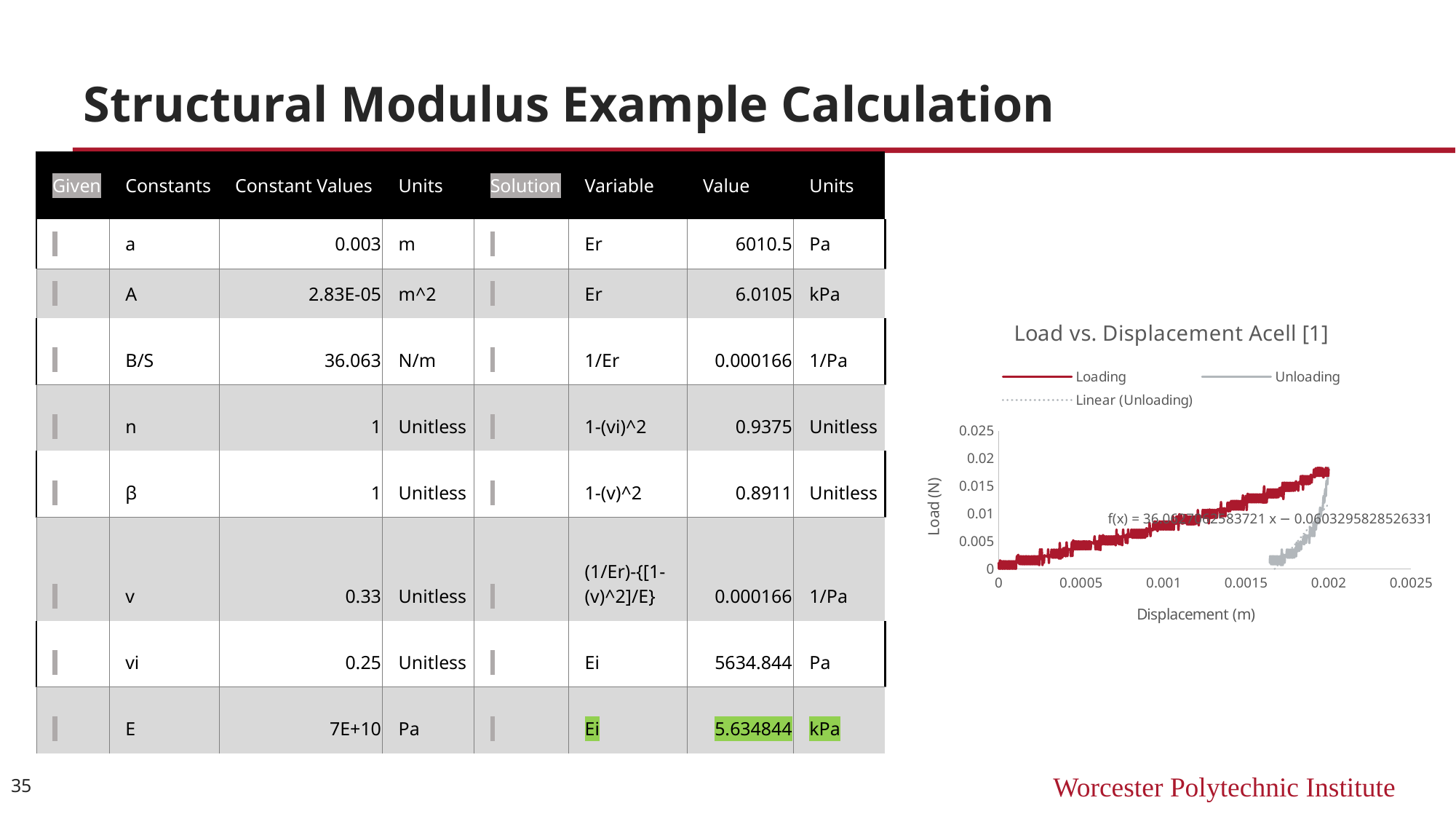
In the Load vs. Displacement chart, is the displacement at which the Unloading series starts (its lowest load point) greater or less than 0.0015 m? greater In the Load vs. Displacement chart, is the displacement at which the Loading series ends greater or less than 0.0025 m? less What kind of chart is the Load vs. Displacement Acell [1] chart? Scatter (line) chart How many series does the legend of the Load vs. Displacement chart list? 3 In the Load vs. Displacement chart, is the maximum load reached by the Loading series greater or less than 0.015 N? greater What is the title of the chart on the slide? Load vs. Displacement Acell [1] What is the label of the x axis of the Load vs. Displacement chart? Displacement (m) In the Load vs. Displacement chart, does the Loading series rise or fall as displacement increases? Rises